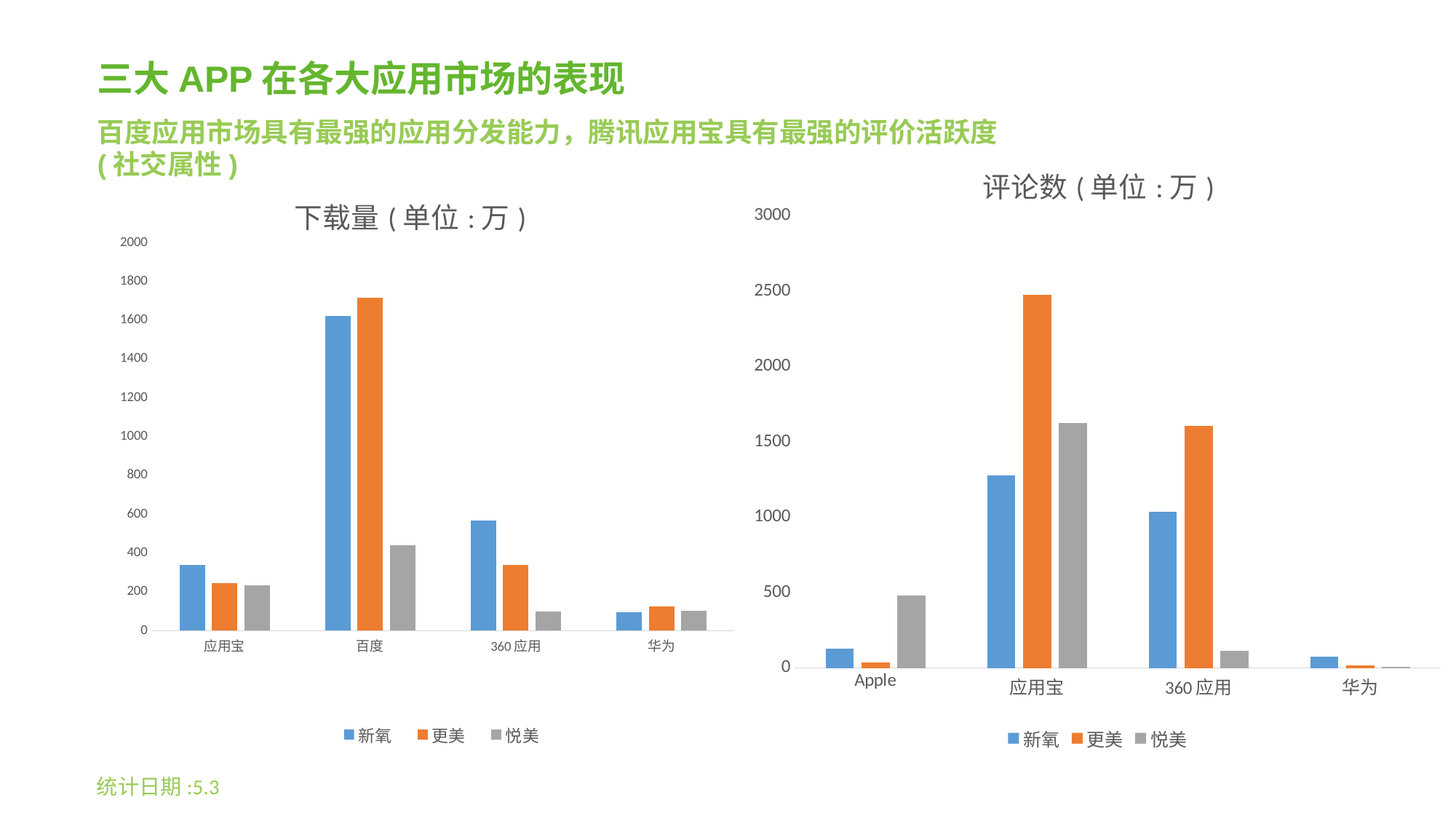
In the 评论数（单位：万） chart, is the value for 更美 at 应用宝 greater or less than 2000? greater In the 下载量（单位：万） chart, which is larger at 360 应用: 新氧 or 悦美? 新氧 In the 评论数（单位：万） chart, which is larger at Apple: 悦美 or 新氧? 悦美 In the 下载量（单位：万） chart, which category has the highest value for 更美? 百度 How many categories are shown on the x axis of the 下载量（单位：万） chart? 4 What kind of chart is the 下载量（单位：万） chart on the left? bar chart How many series does the legend of the 评论数（单位：万） chart list? 3 In the 评论数（单位：万） chart, which category has the highest value for 更美? 应用宝 In the 下载量（单位：万） chart, is the value for 新氧 at 百度 greater or less than 1400? greater In the 评论数（单位：万） chart, which category has the lowest value for 悦美? 华为 What is the title of the chart on the right side of the slide? 评论数（单位：万） In the 评论数（单位：万） chart, is the value for 悦美 at 360 应用 greater or less than 500? less